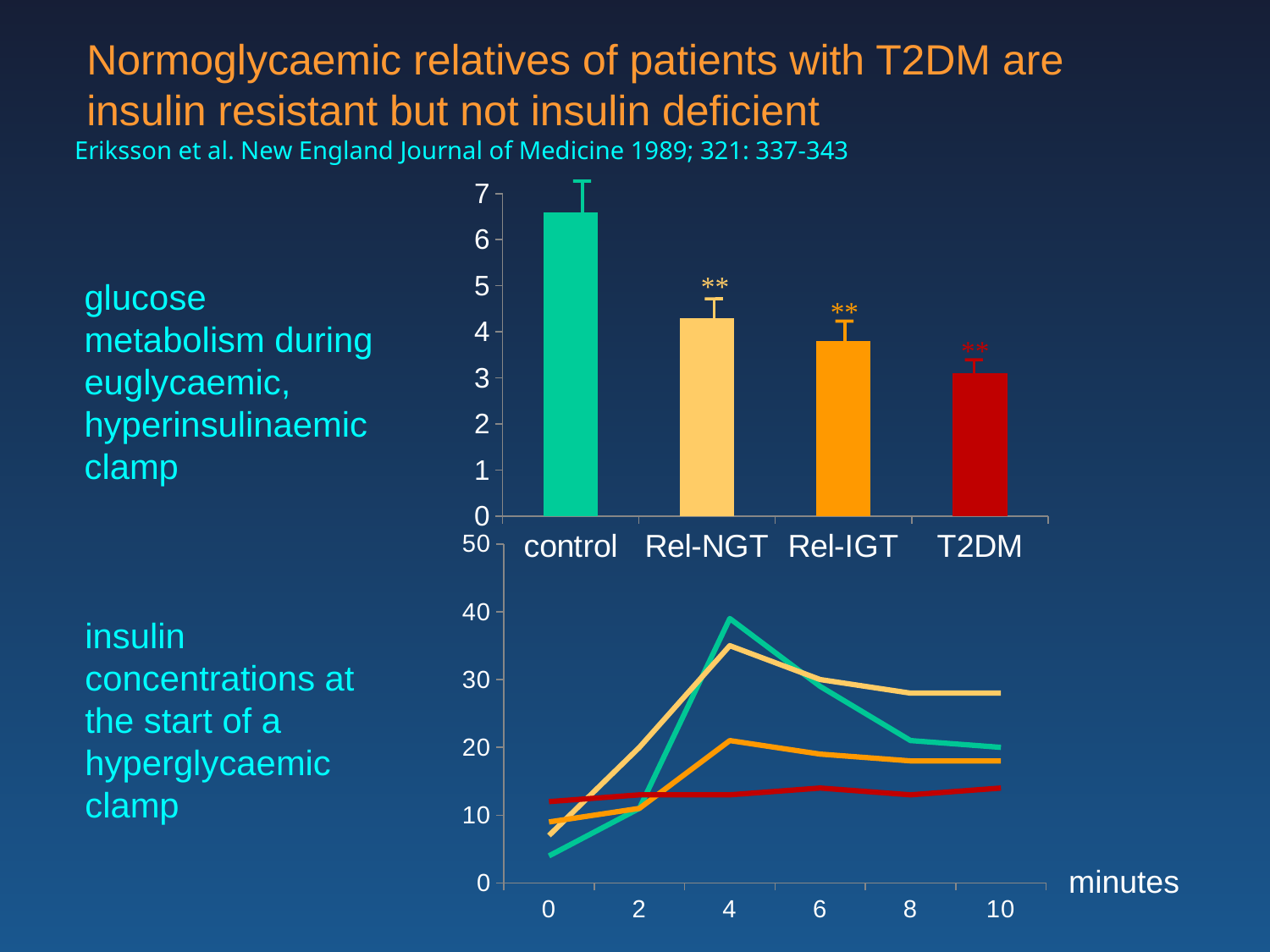
In the top bar chart, is the value for control greater or less than 6? greater In the bottom line chart, is the peak value of the green line greater or less than 35? greater In the top bar chart, how many groups are shown on the x axis? 4 In the top bar chart, which group has the highest glucose metabolism? control What kind of chart is the top chart showing glucose metabolism during the euglycaemic, hyperinsulinaemic clamp? bar chart In the top bar chart, which is larger, the value for Rel-NGT or the value for T2DM? Rel-NGT In the top bar chart, which group has the lowest glucose metabolism? T2DM In the top bar chart, is the value for T2DM greater or less than 4? less What kind of chart is the bottom chart showing insulin concentrations at the start of a hyperglycaemic clamp? line chart In the bottom line chart, what unit is labelled on the x axis? minutes In the bottom line chart, how many lines are plotted? 4